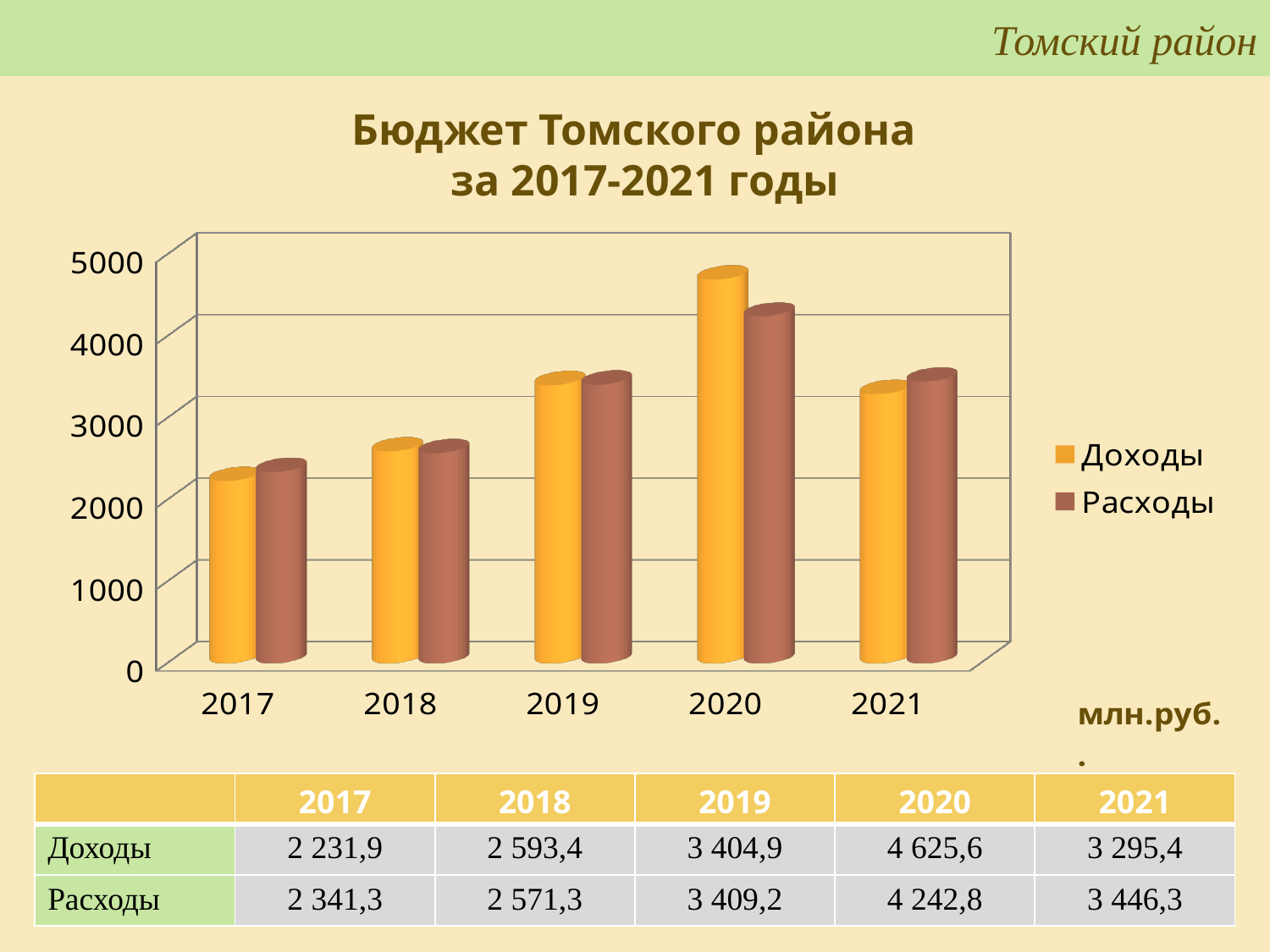
What is the value of Расходы for 2017? 2 341,3 What is the value of Расходы for 2021? 3 446,3 What is the value of Доходы for 2020? 4 625,6 In which year are Доходы highest? 2020 How many years are shown on the x axis? 5 How many series does the legend list? 2 Do Доходы rise or fall from 2017 to 2020? rise In 2020, which is larger, Доходы or Расходы? Доходы What is the difference between Доходы and Расходы in 2020? 382,8 What kind of chart is shown on the slide? bar chart What is the difference between Расходы and Доходы in 2021? 150,9 In which year are Расходы lowest? 2017